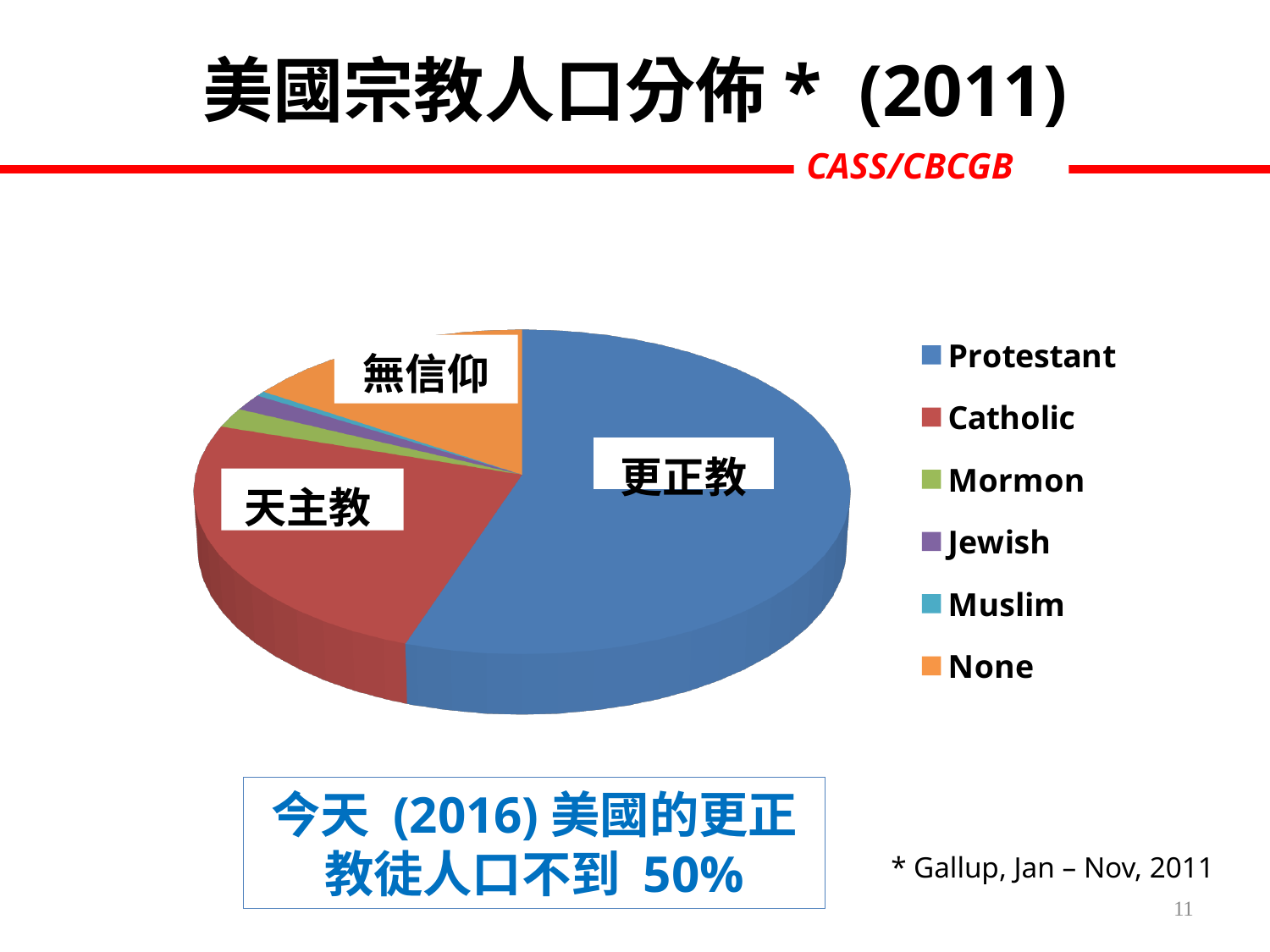
Which category is the second-largest slice of the pie chart? Catholic What colour is the Protestant slice in the pie chart? blue How many categories does the pie chart's legend list? 6 What source is cited for the pie chart data? Gallup, Jan – Nov, 2011 Which slice is larger, Protestant or Catholic? Protestant Which category has the largest slice of the pie chart? Protestant What kind of chart is shown on the slide? pie chart Which slice is larger, Catholic or Jewish? Catholic Which category has the smallest slice of the pie chart? Muslim Which slice is larger, None or Mormon? None